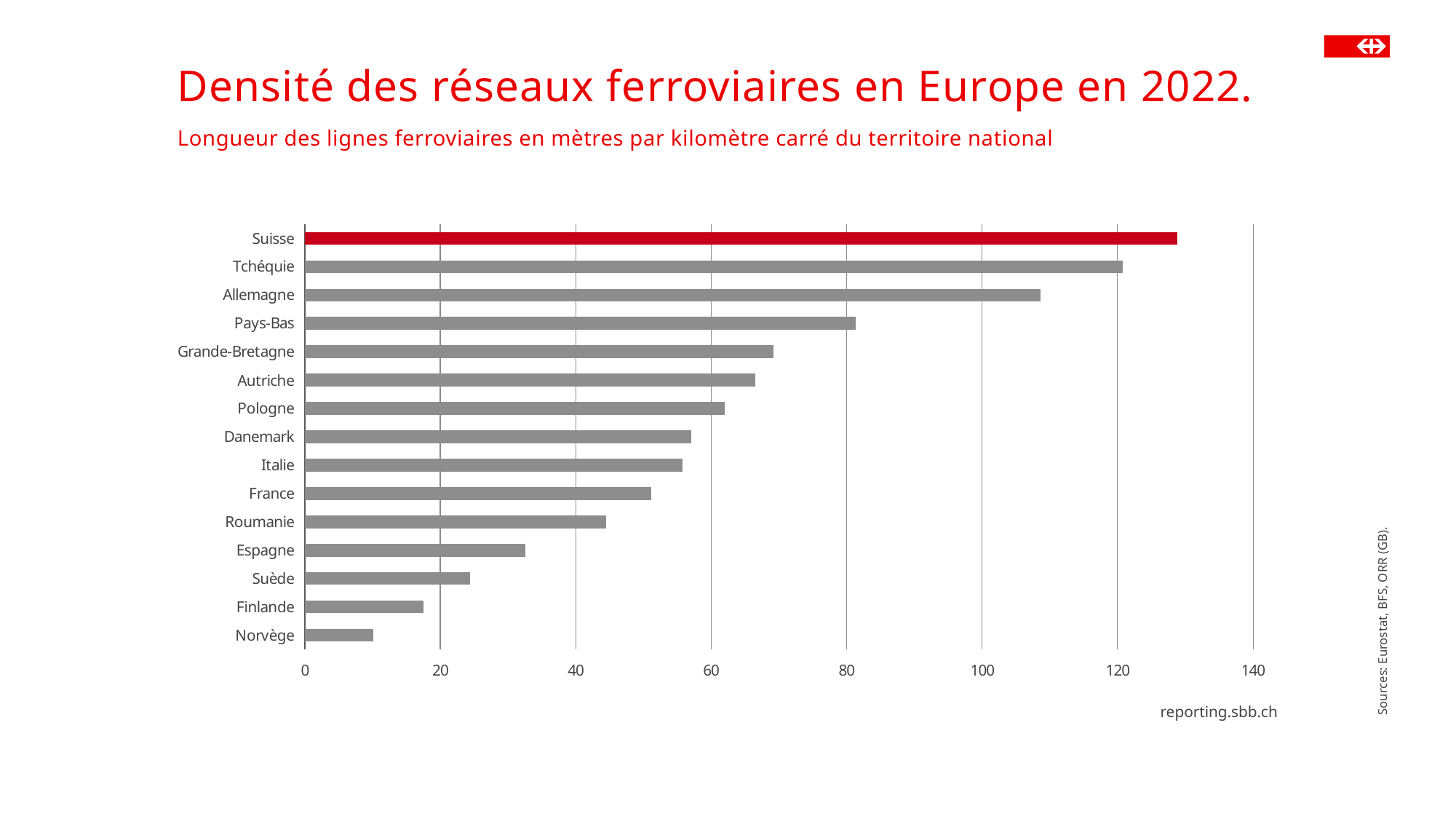
Which has the larger value, Allemagne or Pays-Bas? Allemagne How many countries are plotted in the chart? 15 What kind of chart is shown on the slide? bar chart Which has the larger value, Espagne or Suède? Espagne Which country's bar is highlighted in red in the chart? Suisse Which country has the lowest rail network density in the chart? Norvège Which country has the highest rail network density in the chart? Suisse Is the value for Suisse greater or less than 120? greater Is the value for Allemagne greater or less than 100? greater Is the value for Espagne greater or less than 40? less